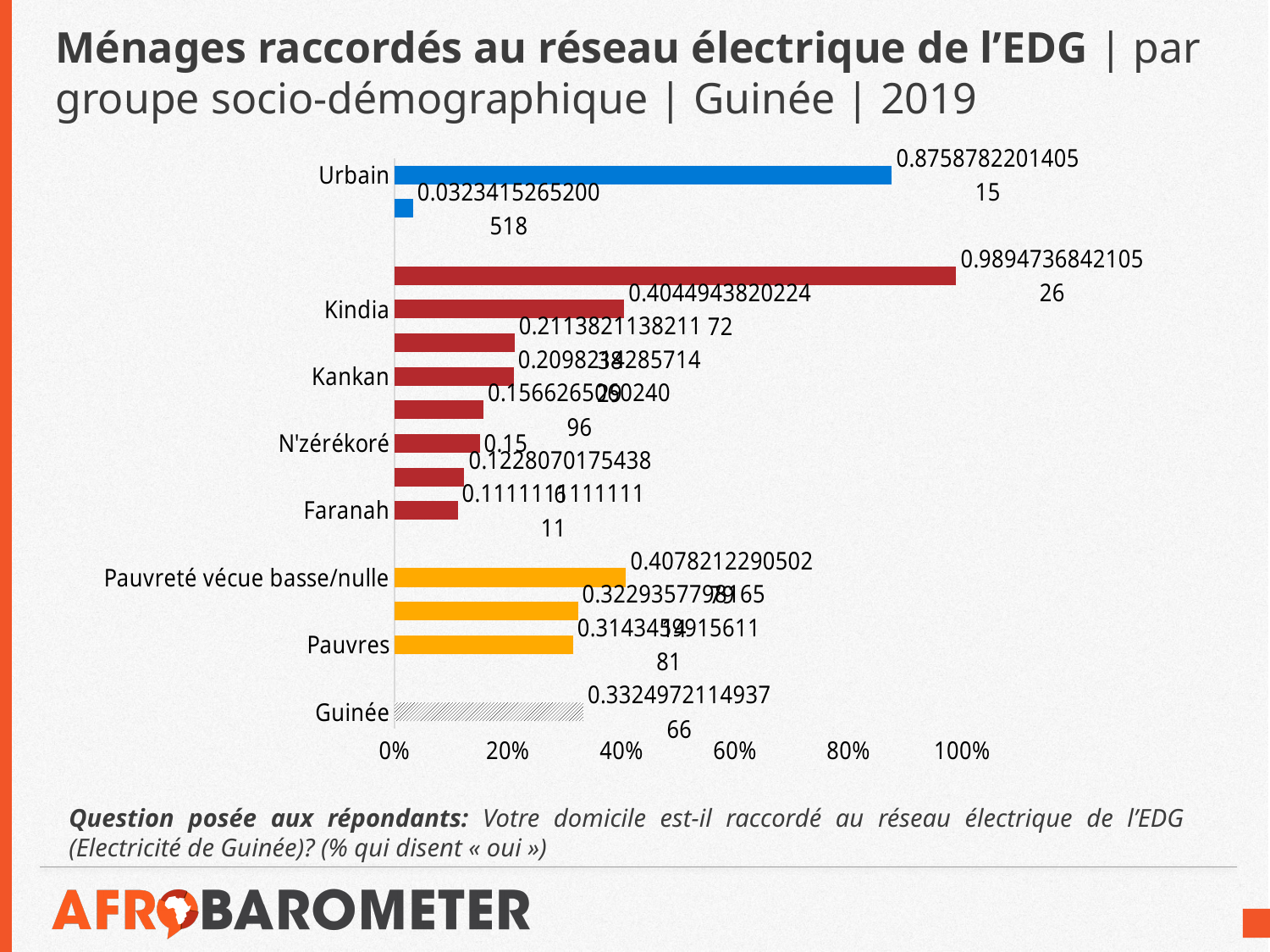
Is the value for Kindia greater or less than 60%? less Is the value for Guinée greater or less than 20%? greater What colour is the bar for Urbain? blue What type of chart is shown on the slide? bar chart Is the value for Kankan greater or less than 40%? less Which is larger, the value for Pauvreté vécue basse/nulle or the value for Pauvres? Pauvreté vécue basse/nulle What is the highest tick label shown on the horizontal axis? 100% Which is larger, the value for Urbain or the value for Guinée? Urbain What value is printed on the bar for N'zérékoré? 0.15 Which is larger, the value for Kindia or the value for Kankan? Kindia